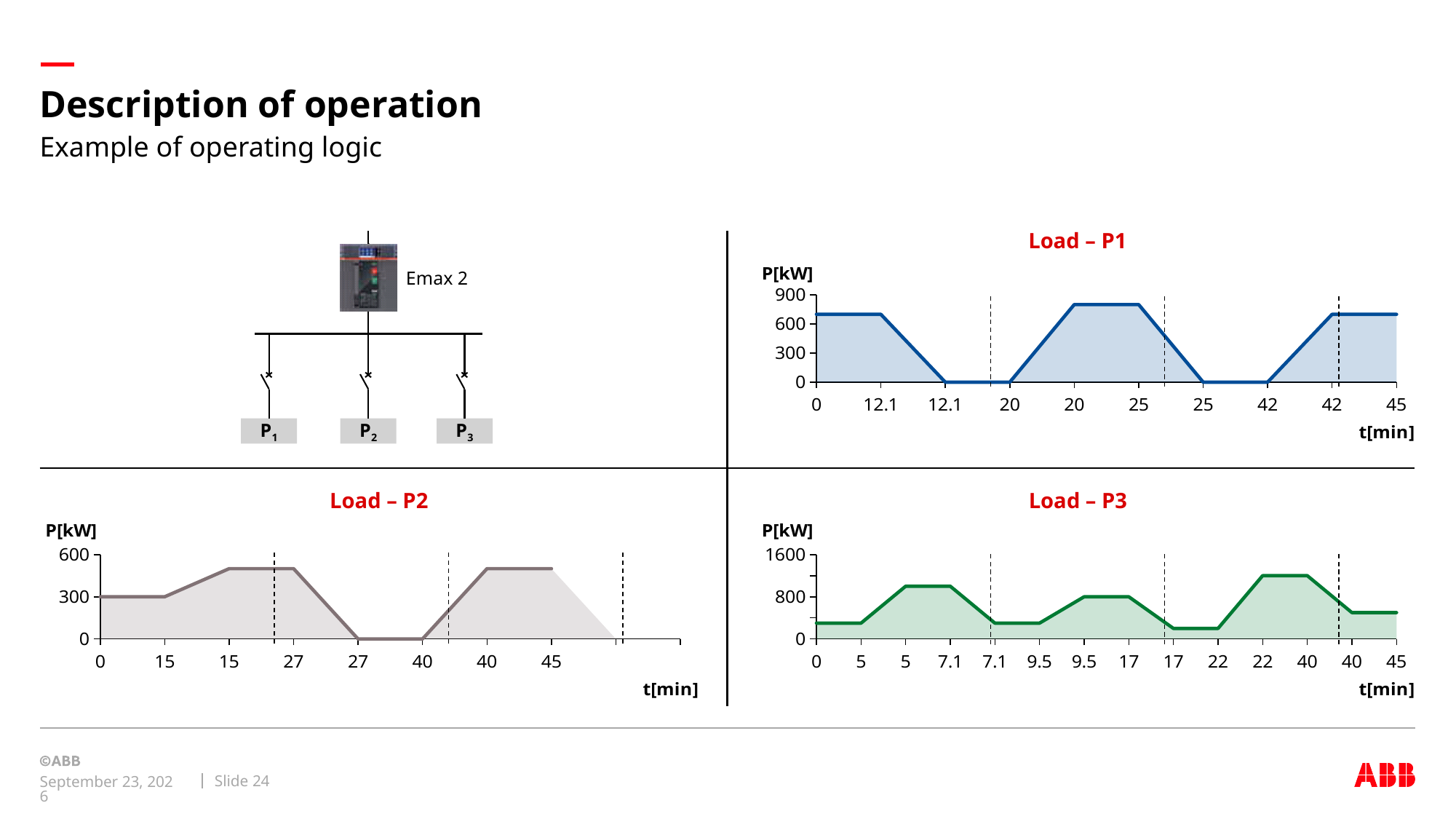
On the Load – P3 chart, is the value of P at t = 0 min greater or less than 800? less On the Load – P1 chart, what is the value of P at t = 12.1 to 20 min (the flat section after the first ramp down)? 0 On the Load – P2 chart, is the value of P between t = 15 and t = 27 min greater or less than 300? greater On the Load – P2 chart, what is the value of P at t = 0 min? 300 On the Load – P1 chart, is the peak value between t = 20 and t = 25 min greater or less than 900? less What unit is shown on the horizontal axis of the Load – P1 chart? t[min] On the Load – P3 chart, what is the value of P between t = 9.5 and t = 17 min? 800 On the Load – P3 chart, is the value between t = 22 and t = 40 min higher or lower than the value between t = 9.5 and t = 17 min? higher What is the highest tick value shown on the vertical axis of the Load – P3 chart? 1600 On the Load – P2 chart, what is the value of P between t = 27 and t = 40 min? 0